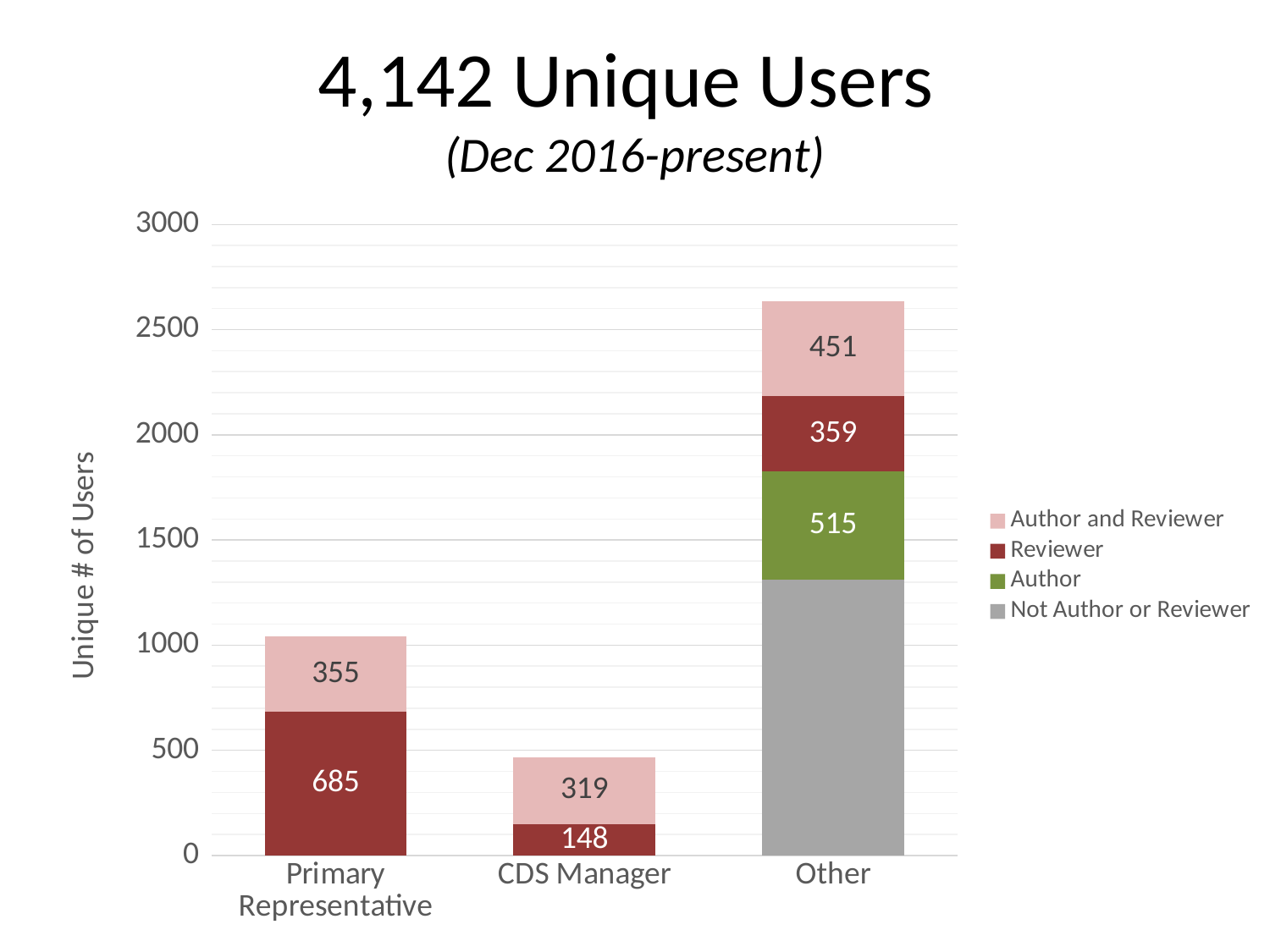
How many series does the legend list? 4 What is the total of the stacked bar for Primary Representative? 1040 What is the Author and Reviewer value for CDS Manager? 319 Which category has the highest Reviewer value? Primary Representative Which is larger, the Author and Reviewer value for Other or for Primary Representative? Other How many categories are shown on the x axis? 3 What is the Reviewer value for Other? 359 Which category has the lowest Author and Reviewer value? CDS Manager What is the Author value for Other? 515 What is the difference between the Reviewer values for Primary Representative and CDS Manager? 537 What is the Reviewer value for Primary Representative? 685 Is the Not Author or Reviewer value for Other greater or less than 1000? greater